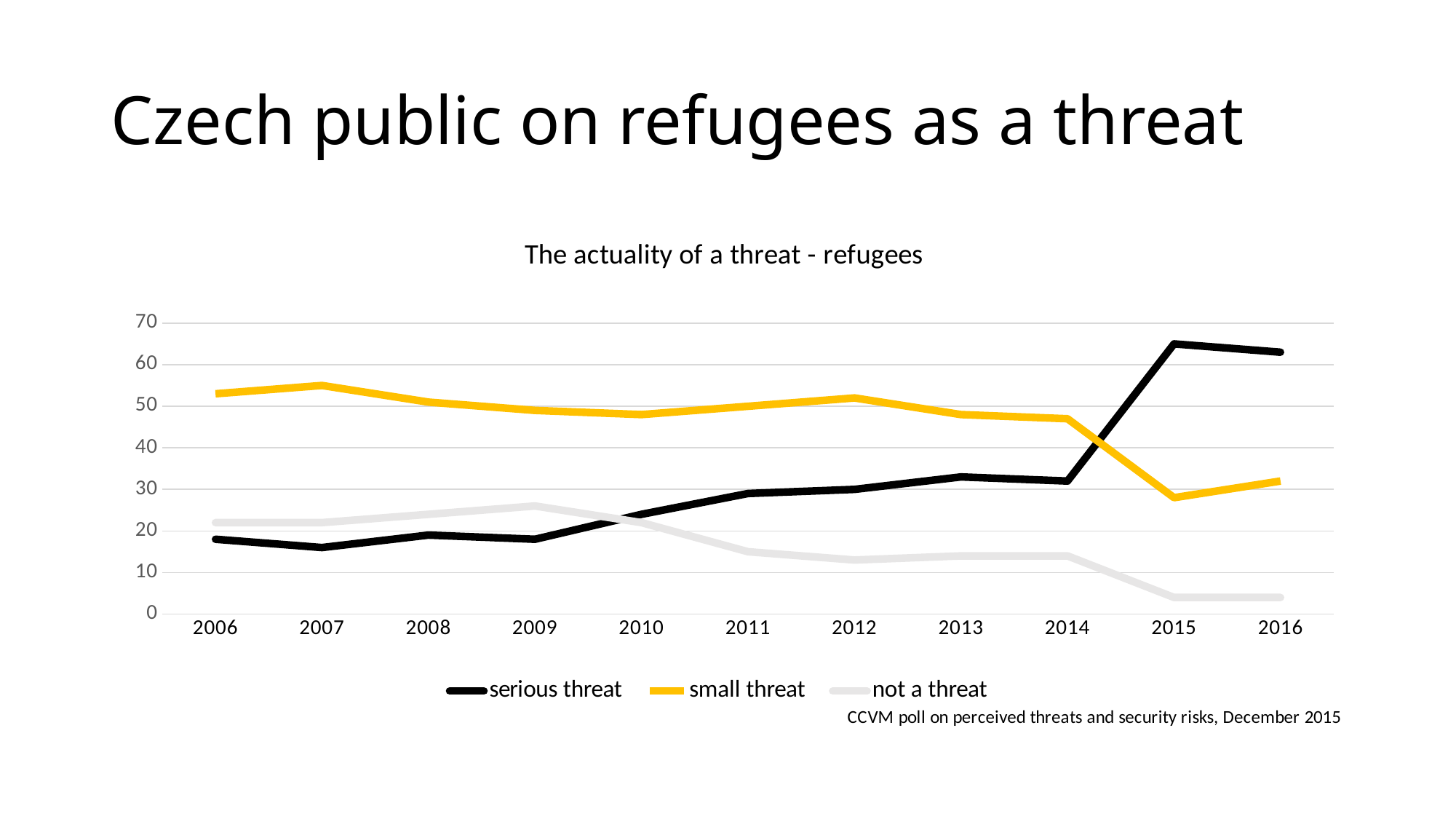
How many years are shown on the x axis? 11 How many series does the legend list? 3 Is the value for 'small threat' in 2007 greater or less than 50? greater In which year is the 'small threat' series at its lowest? 2015 Does the 'not a threat' series rise or fall from 2010 to 2016? fall In which year is the 'serious threat' series at its highest? 2015 In 2014, which series has the larger value: 'small threat' or 'serious threat'? small threat Is the value for 'serious threat' in 2015 greater or less than 60? greater In 2016, which series has the larger value: 'serious threat' or 'small threat'? serious threat What is the title of the chart? The actuality of a threat - refugees Is the value for 'not a threat' in 2016 greater or less than 10? less What kind of chart is shown on the slide? line chart